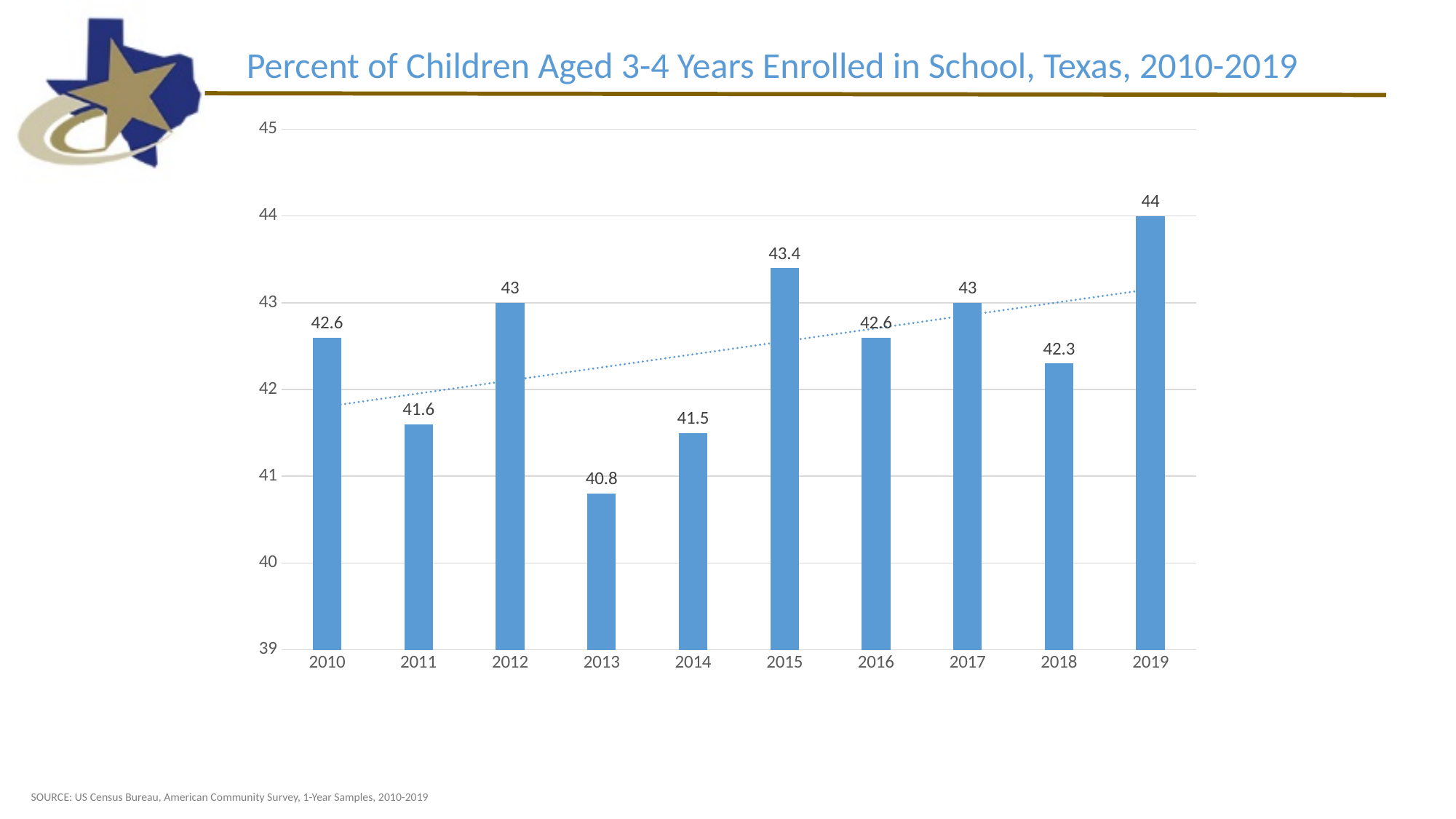
What is the title of the chart? Percent of Children Aged 3-4 Years Enrolled in School, Texas, 2010-2019 Which year has the highest value? 2019 What is the value for 2013? 40.8 What is the value for 2019? 44 What is the difference between the values for 2015 and 2014? 1.9 What kind of chart is this? bar chart Is the value for 2011 greater or less than 42? less Which year has the lowest value? 2013 What is the value for 2015? 43.4 What is the difference between the values for 2019 and 2013? 3.2 Which is larger, the value for 2012 or the value for 2018? 2012 How many years are shown on the x axis? 10